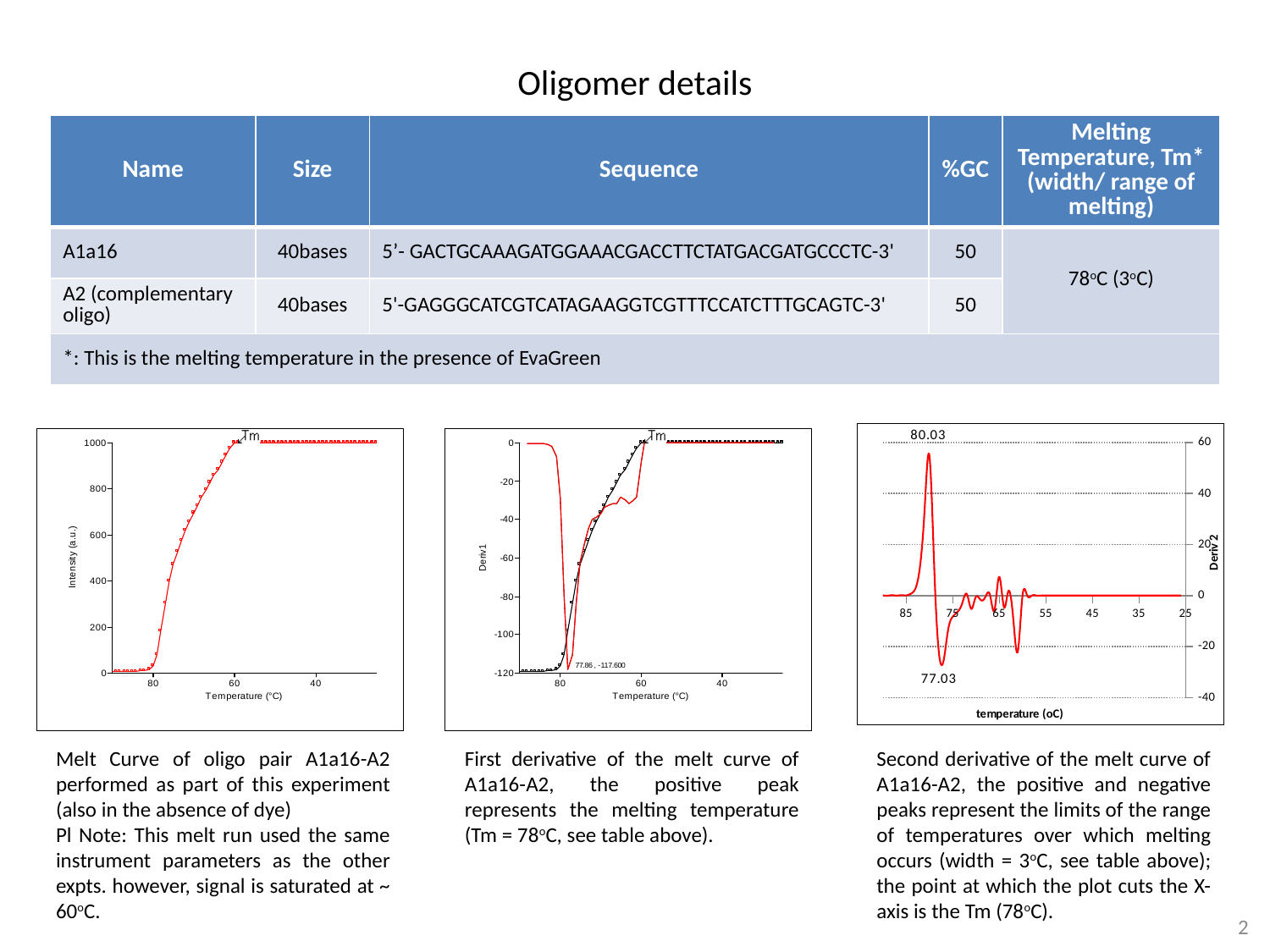
On the left chart, what is the label of the y-axis? Intensity (a.u.) On the middle chart (Deriv1), what is the lowest tick value shown on the y-axis? -120 On the right chart (Deriv2), what is the label of the x-axis? temperature (oC) On the left chart, what is the highest tick value shown on the y-axis? 1000 On the left chart, is the intensity at 60 °C greater or less than 800? greater On the right chart (Deriv2), what is the difference between the two printed temperature values, 80.03 and 77.03? 3 On the right chart (Deriv2), what temperature value is printed at the negative peak? 77.03 On the right chart (Deriv2), is the height of the positive peak greater or less than 40? greater What kind of chart is the left chart (Intensity vs Temperature)? line chart On the middle chart (Deriv1), what are the coordinates printed at the labeled minimum point? 77.86, -117.600 On the right chart (Deriv2), what temperature value is printed at the positive peak? 80.03